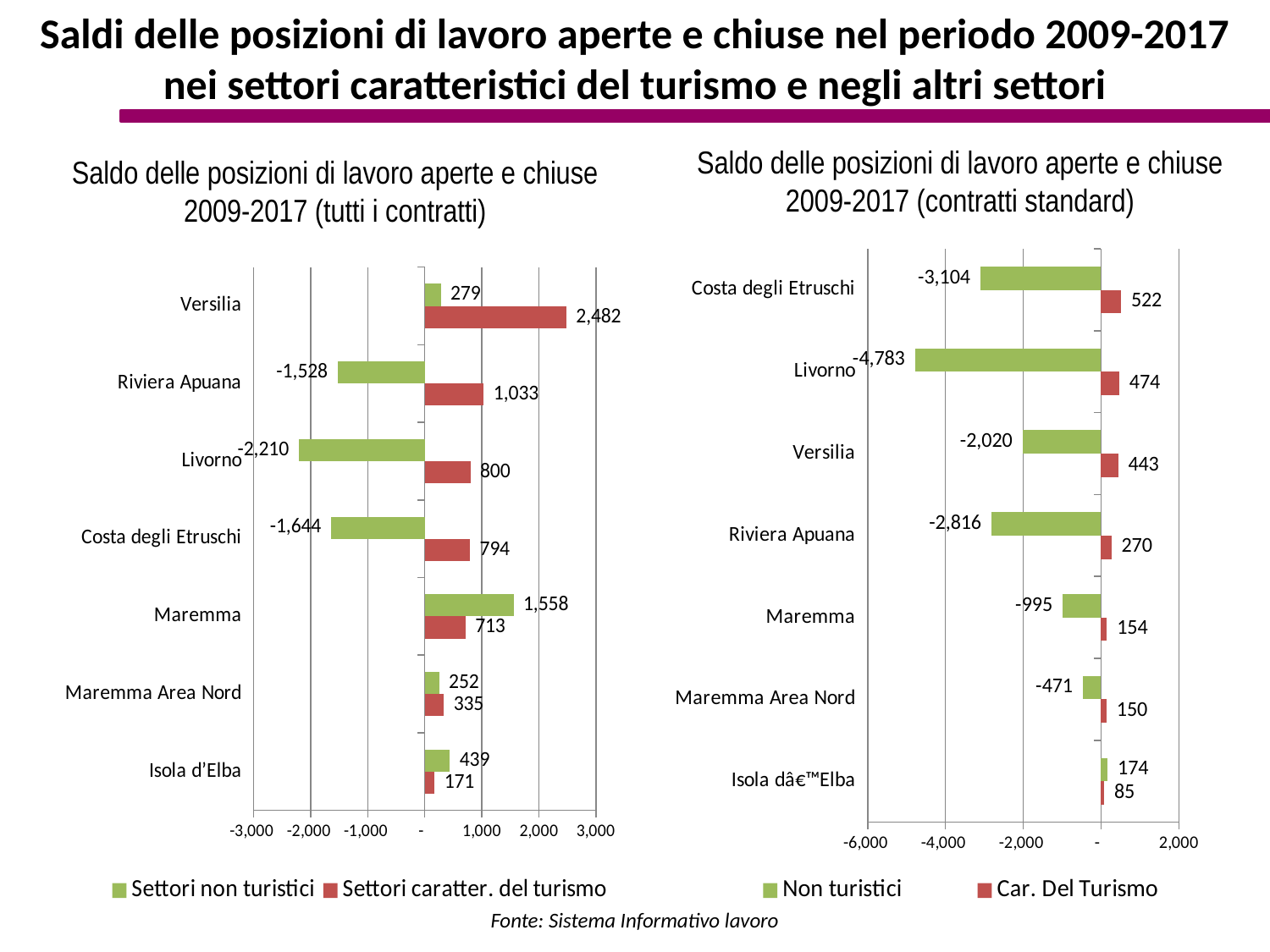
What is the source cited at the bottom of the slide? Fonte: Sistema Informativo lavoro In the left chart (tutti i contratti), what is the value for Settori caratter. del turismo for Versilia? 2,482 How many areas are shown in the left chart (tutti i contratti)? 7 What type of chart is the left chart (tutti i contratti)? Bar chart In the left chart (tutti i contratti), what is the difference between the Settori caratter. del turismo values for Versilia and Riviera Apuana? 1,449 In the right chart (contratti standard), which area has the lowest value for Non turistici? Livorno In the right chart (contratti standard), what is the value for Car. Del Turismo for Costa degli Etruschi? 522 In the right chart (contratti standard), which is larger for Maremma: the Non turistici value or the Car. Del Turismo value? Car. Del Turismo In the left chart (tutti i contratti), what is the value for Settori non turistici for Livorno? -2,210 In the left chart (tutti i contratti), which area has the highest value for Settori caratter. del turismo? Versilia How many series does the legend of the right chart (contratti standard) list? 2 In the right chart (contratti standard), what is the value for Non turistici for Livorno? -4,783